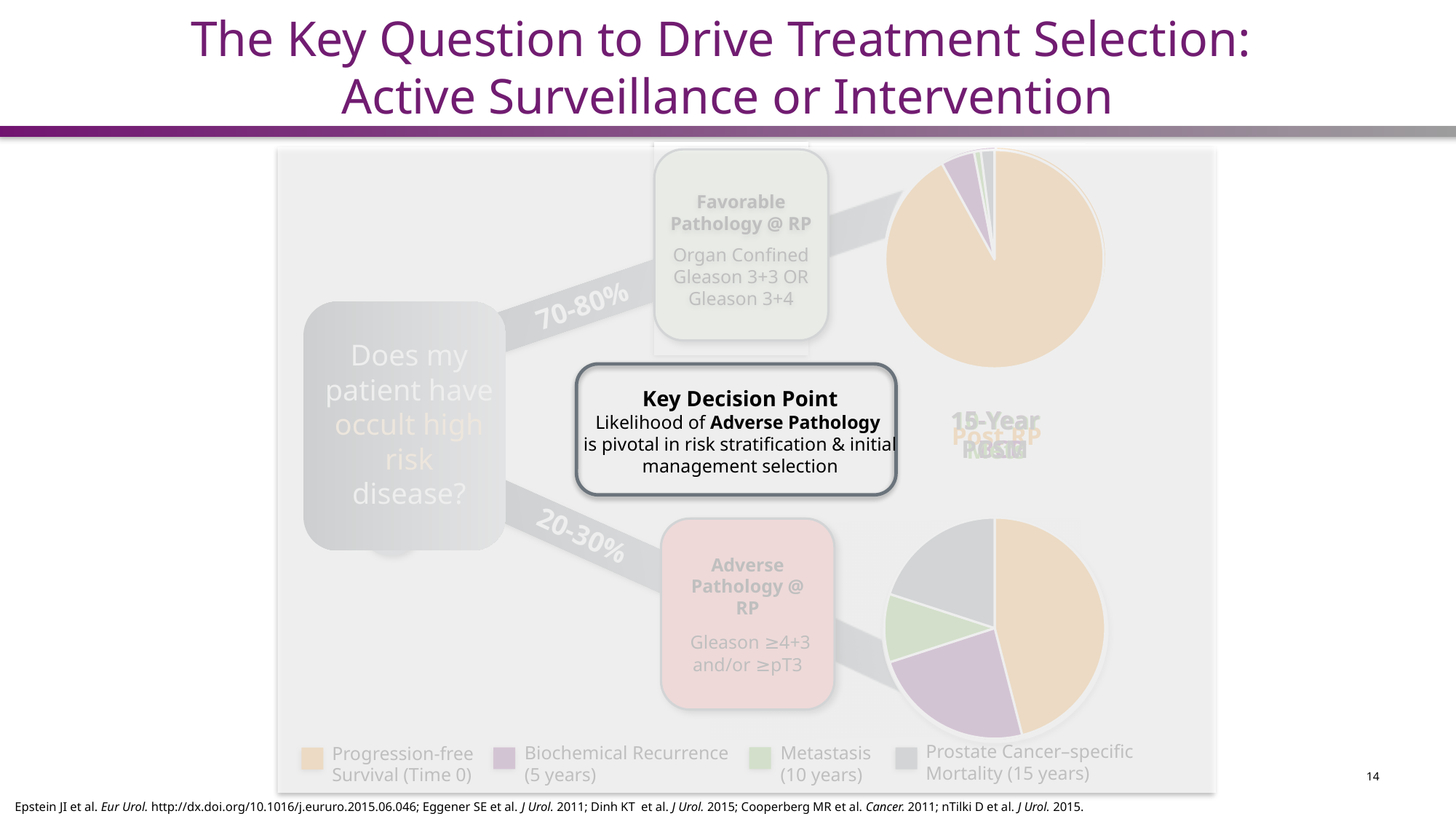
What kind of chart is shown at the bottom right of the slide, next to the 'Adverse Pathology @ RP' box? Pie chart In the top pie chart (next to 'Favorable Pathology @ RP'), which category has the largest slice? Progression-free Survival (Time 0) How many slices does the bottom pie chart (next to 'Adverse Pathology @ RP') have? 4 In the bottom pie chart (next to 'Adverse Pathology @ RP'), which category has the largest slice? Progression-free Survival (Time 0) In the bottom pie chart (next to 'Adverse Pathology @ RP'), which category has the smallest slice? Metastasis (10 years) Which legend entry is shown in green? Metastasis (10 years) In the top pie chart (next to 'Favorable Pathology @ RP'), which slice is larger: Progression-free Survival (Time 0) or Biochemical Recurrence (5 years)? Progression-free Survival (Time 0) What kind of chart is shown at the top right of the slide, next to the 'Favorable Pathology @ RP' box? Pie chart In the bottom pie chart (next to 'Adverse Pathology @ RP'), which slice is larger: Biochemical Recurrence (5 years) or Metastasis (10 years)? Biochemical Recurrence (5 years) Which legend entry is shown in grey? Prostate Cancer–specific Mortality (15 years) How many entries does the legend at the bottom of the slide list? 4